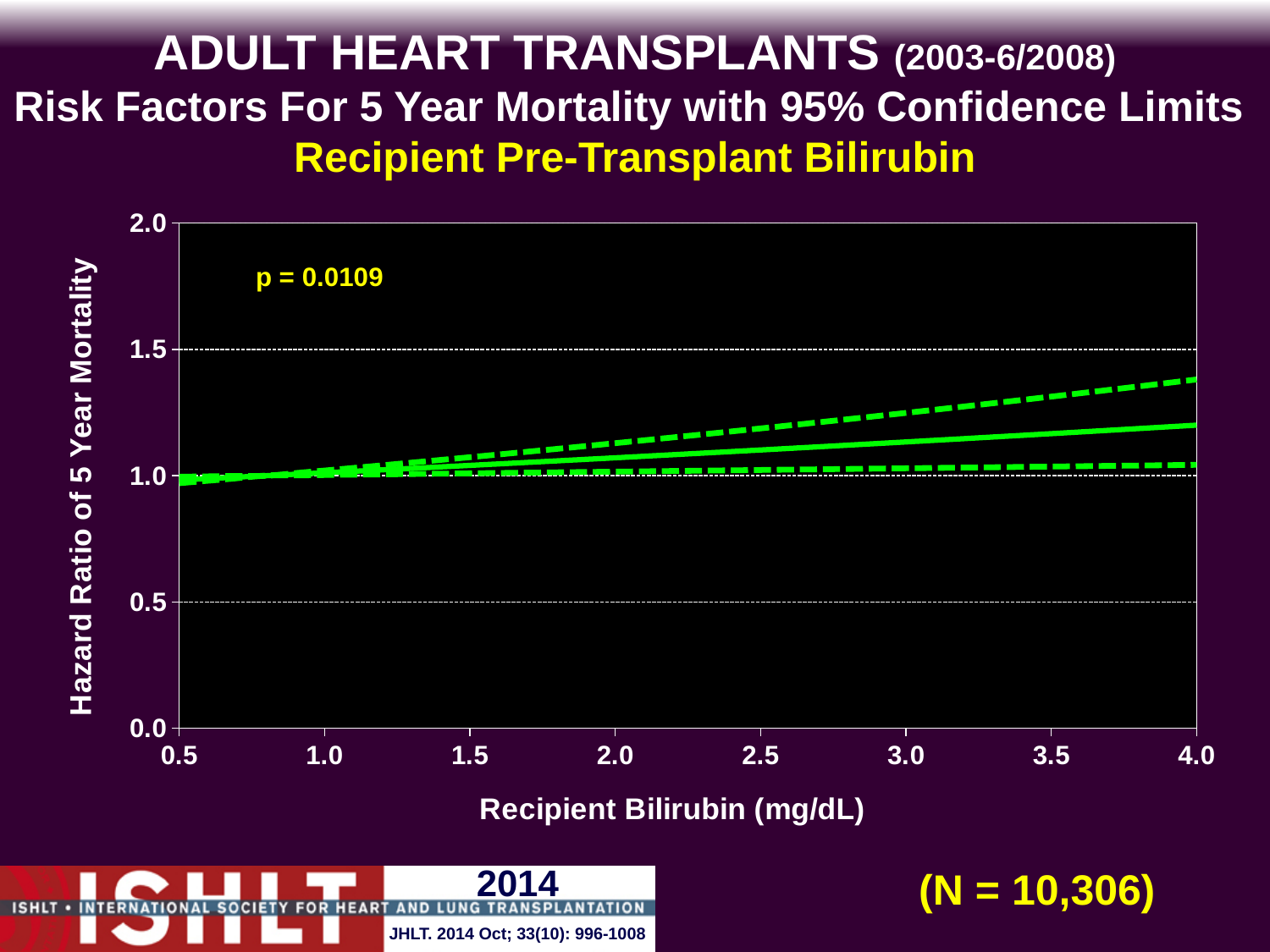
How many lines are plotted on the chart? 3 Is the upper 95% confidence limit (upper dashed line) at a recipient bilirubin of 4.0 mg/dL greater or less than 1.0? greater How many tick marks are labelled on the x axis? 8 What p-value is printed on the chart? p = 0.0109 What is the lowest recipient bilirubin value labelled on the x axis? 0.5 Does the hazard ratio of 5 year mortality rise or fall as recipient bilirubin increases from 0.5 to 4.0 mg/dL? rise What kind of chart is shown on the slide? line chart What is the sample size (N) shown on the slide? N = 10,306 Is the hazard ratio (solid line) at a recipient bilirubin of 4.0 mg/dL greater or less than 1.0? greater Is the hazard ratio (solid line) at a recipient bilirubin of 4.0 mg/dL greater or less than 1.5? less What is the highest value labelled on the y axis? 2.0